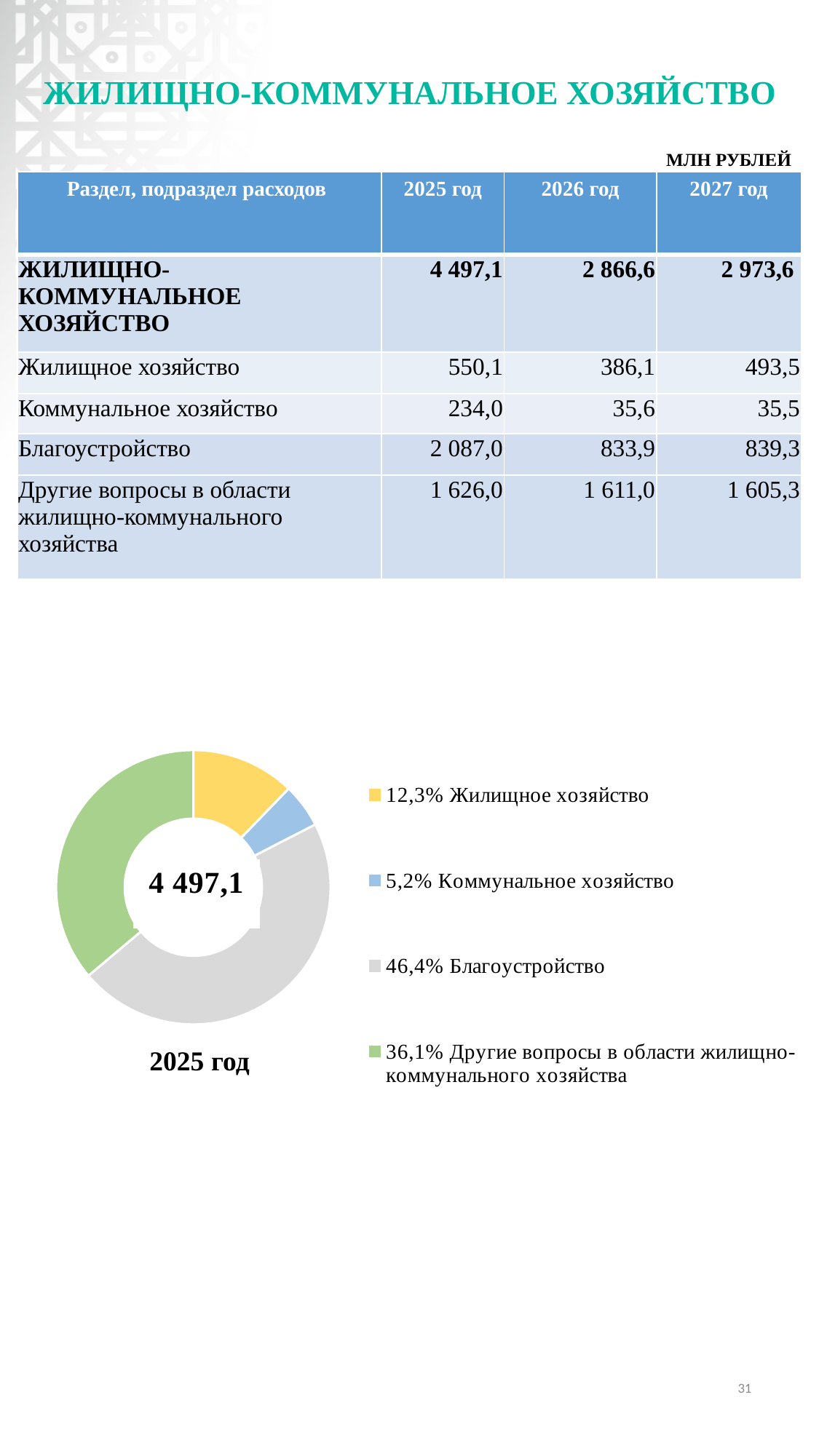
Which category has the largest slice in the pie chart? Благоустройство In the pie chart, which is larger: the share of Жилищное хозяйство or the share of Коммунальное хозяйство? Жилищное хозяйство What share of the pie chart does Благоустройство take? 46,4% Which category has the smallest slice in the pie chart? Коммунальное хозяйство Which year does the pie chart represent, according to the label below it? 2025 год How many slices does the pie chart have? 4 What total value is printed in the centre of the pie chart? 4 497,1 What share of the pie chart does Другие вопросы в области жилищно-коммунального хозяйства take? 36,1% What kind of chart is shown on the slide? Pie (donut) chart What share of the pie chart does Жилищное хозяйство take? 12,3% What is the difference in percentage points between the shares of Благоустройство and Другие вопросы в области жилищно-коммунального хозяйства in the pie chart? 10,3